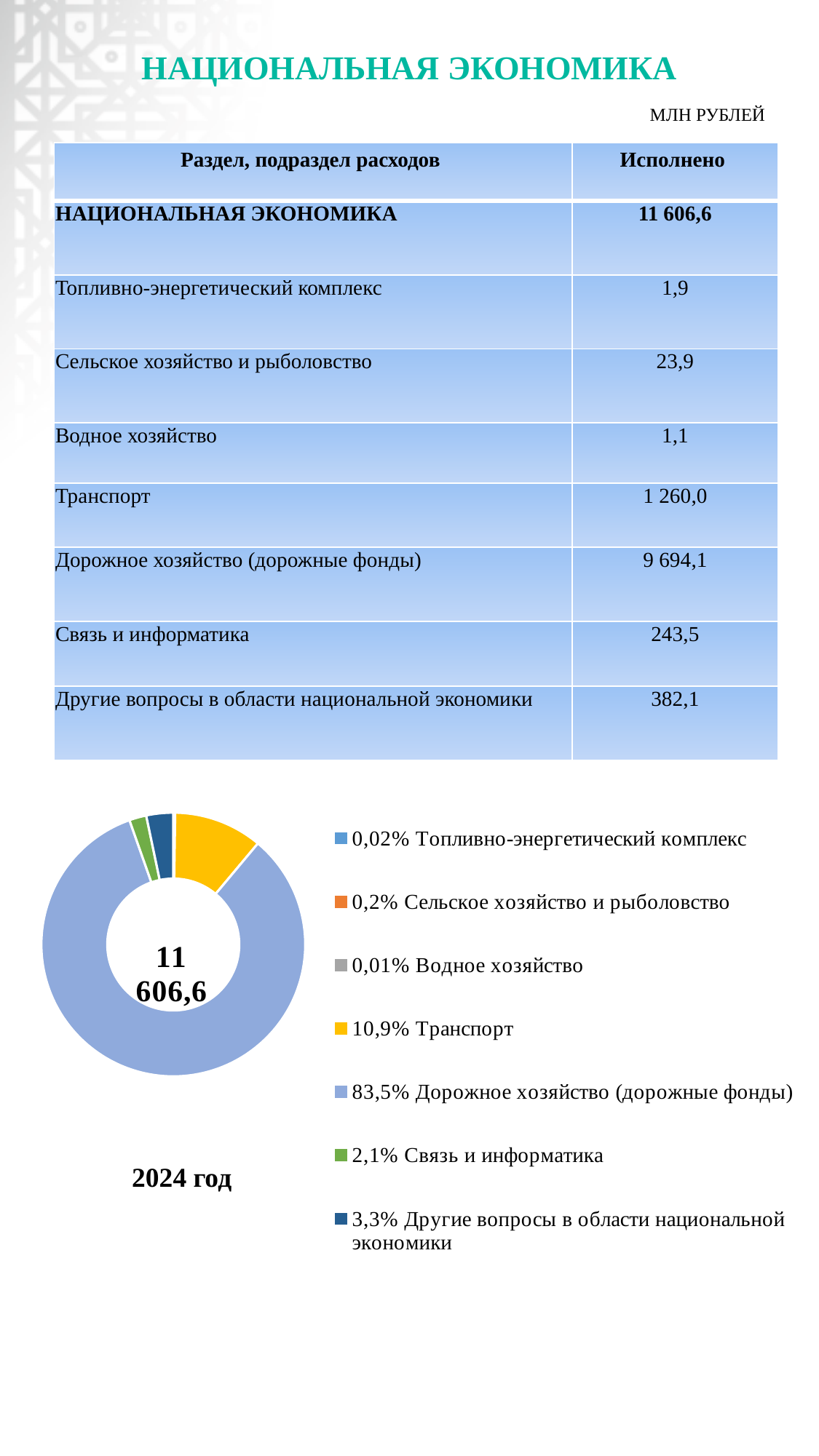
How many categories does the legend of the doughnut chart list? 7 According to the legend of the doughnut chart, what share does Связь и информатика have? 2,1% According to the legend of the doughnut chart, what share does Другие вопросы в области национальной экономики have? 3,3% In the doughnut chart, which has the larger share: Транспорт or Связь и информатика? Транспорт What kind of chart is shown at the bottom of the slide? Doughnut (pie) chart What total value is printed in the centre of the doughnut chart? 11 606,6 What year is printed below the doughnut chart? 2024 год According to the legend of the doughnut chart, what share does Дорожное хозяйство (дорожные фонды) have? 83,5% Which category has the largest slice in the doughnut chart? Дорожное хозяйство (дорожные фонды) What colour is the slice for Транспорт in the doughnut chart? Yellow Which category has the smallest share in the doughnut chart according to the legend? Водное хозяйство